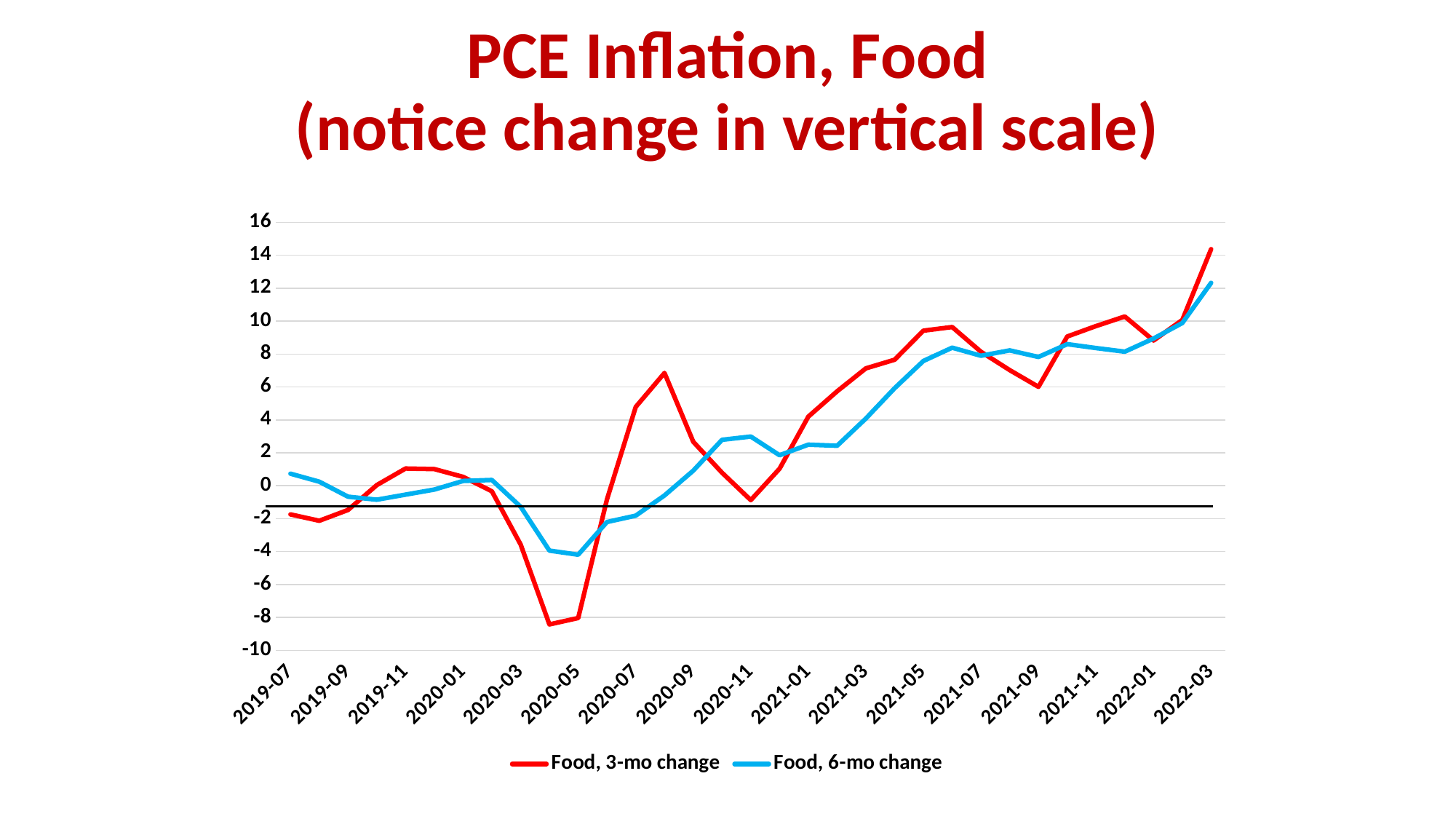
Which series reaches the lowest value on the chart? Food, 3-mo change Is the value of Food, 3-mo change at 2020-04 greater or less than -6? less Does Food, 6-mo change generally rise or fall from 2020-05 to 2022-03? rise At 2020-11, which series has the higher value, Food, 3-mo change or Food, 6-mo change? Food, 6-mo change Is the value of Food, 3-mo change at 2022-03 greater or less than 12? greater What is the title of the chart? PCE Inflation, Food (notice change in vertical scale) Is the value of Food, 6-mo change at 2020-05 greater or less than -2? less What kind of chart is shown on the slide? line chart How many series does the legend list? 2 Which series is drawn in blue? Food, 6-mo change At which date does Food, 3-mo change reach its highest value? 2022-03